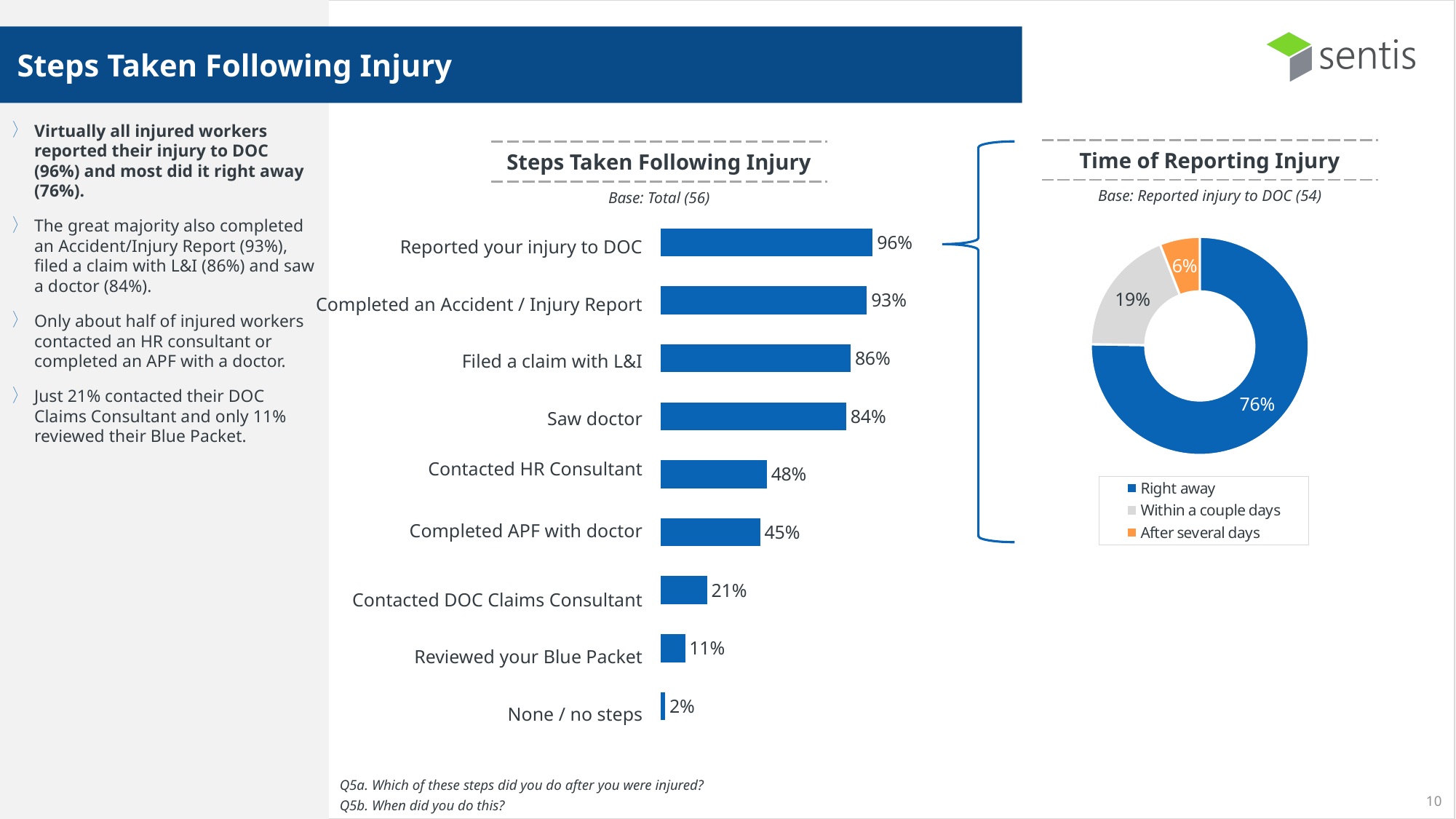
How many steps (categories) are shown in the 'Steps Taken Following Injury' chart? 9 In the 'Steps Taken Following Injury' chart, what percentage reported their injury to DOC? 96% In the 'Steps Taken Following Injury' chart, which step has the highest value? Reported your injury to DOC In the 'Steps Taken Following Injury' chart, which step has the lowest value? None / no steps In the 'Time of Reporting Injury' chart, what is the value for 'After several days'? 6% In the 'Steps Taken Following Injury' chart, what is the value for 'Contacted HR Consultant'? 48% In the 'Steps Taken Following Injury' chart, which is larger: 'Contacted DOC Claims Consultant' or 'Reviewed your Blue Packet'? Contacted DOC Claims Consultant What kind of chart is the 'Steps Taken Following Injury' chart? Bar chart In the 'Steps Taken Following Injury' chart, what is the difference between 'Filed a claim with L&I' and 'Saw doctor'? 2% In the 'Time of Reporting Injury' chart, what share reported their injury right away? 76% What is the base noted under the 'Time of Reporting Injury' chart? Reported injury to DOC (54) How many categories does the legend of the 'Time of Reporting Injury' chart list? 3